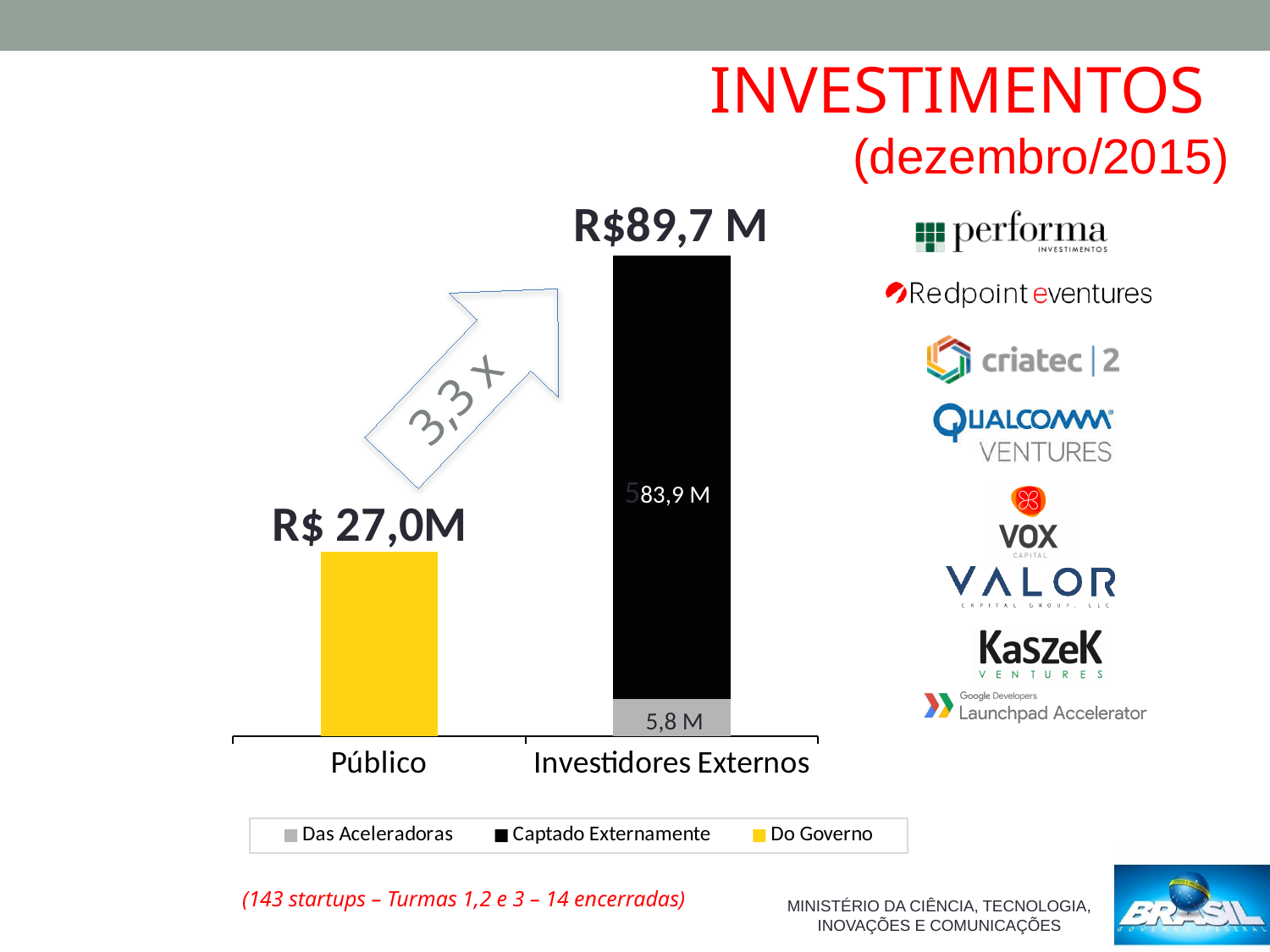
Which category has the lowest total value? Público How many categories are shown on the x axis of the chart? 2 Which legend entry is shown in yellow? Do Governo What is the value of the Captado Externamente segment in the Investidores Externos bar? 83,9 M What is the total value labelled above the Investidores Externos bar? R$89,7 M Within the Investidores Externos bar, which segment is larger, Captado Externamente or Das Aceleradoras? Captado Externamente What is the value of the Das Aceleradoras segment in the Investidores Externos bar? 5,8 M How many series does the chart legend list? 3 What kind of chart is shown on the slide? bar chart Which category has the higher total value, Público or Investidores Externos? Investidores Externos What multiplier is written on the arrow between the two bars? 3,3 X What is the value labelled above the Público bar? R$ 27,0M